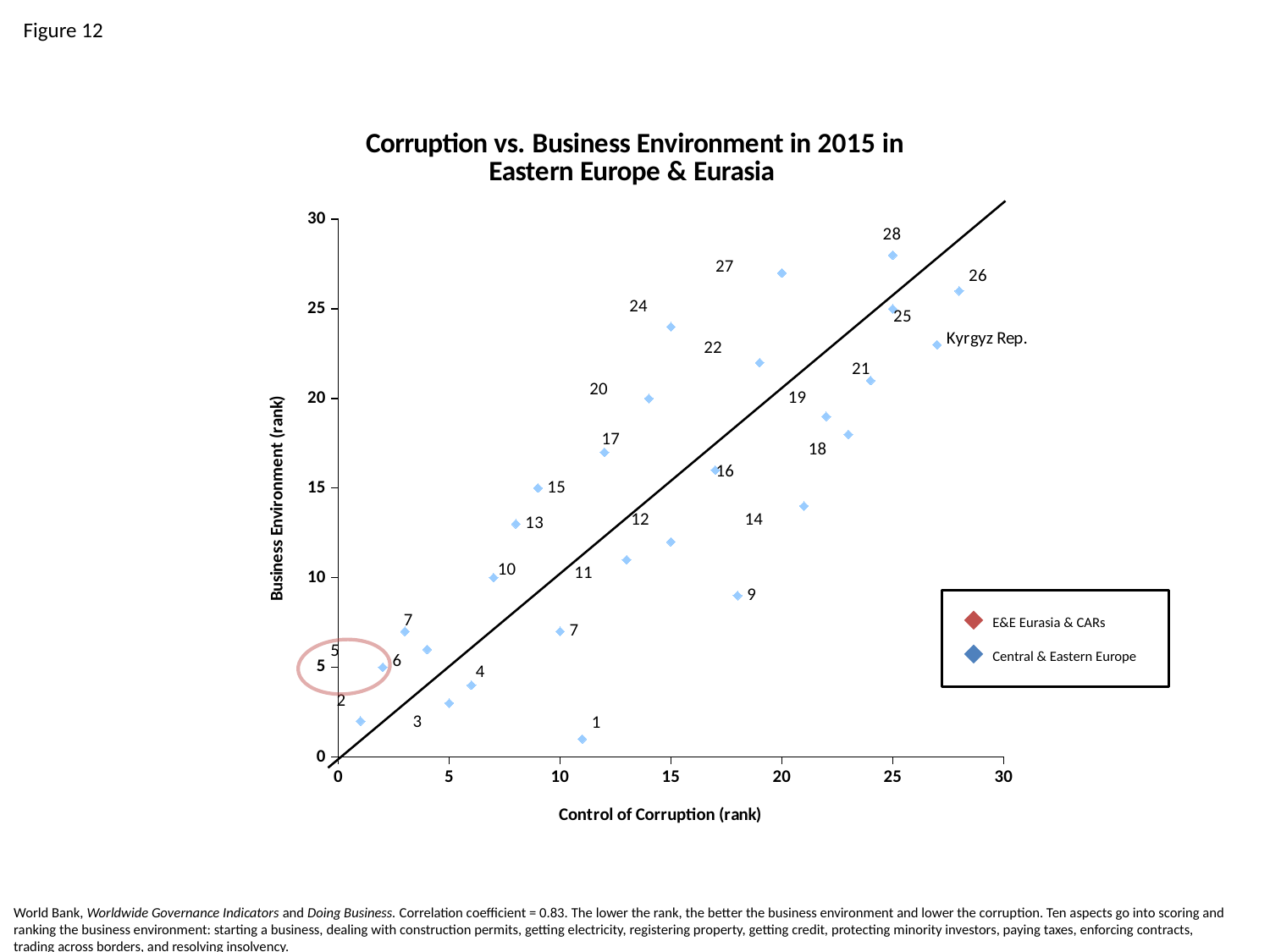
Is the Control of Corruption rank for the point labelled 28 greater or less than 20? greater Is the Business Environment rank for Kyrgyz Rep. greater or less than 20? greater What is the title of the x axis? Control of Corruption (rank) What are the two series named in the legend? E&E Eurasia & CARs; Central & Eastern Europe As Control of Corruption rank increases along the x axis, do Business Environment ranks generally rise or fall? rise How many series does the legend list? 2 What kind of chart is shown on the slide? scatter chart What is the lowest Business Environment rank labelled on the chart? 1 Is the Control of Corruption rank for Kyrgyz Rep. greater or less than 25? greater What is the difference between the highest labelled Business Environment rank (28) and the lowest (1)? 27 Which point has the higher Business Environment rank, the one labelled 27 or the one labelled 24? 27 What is the highest Business Environment rank labelled on the chart? 28